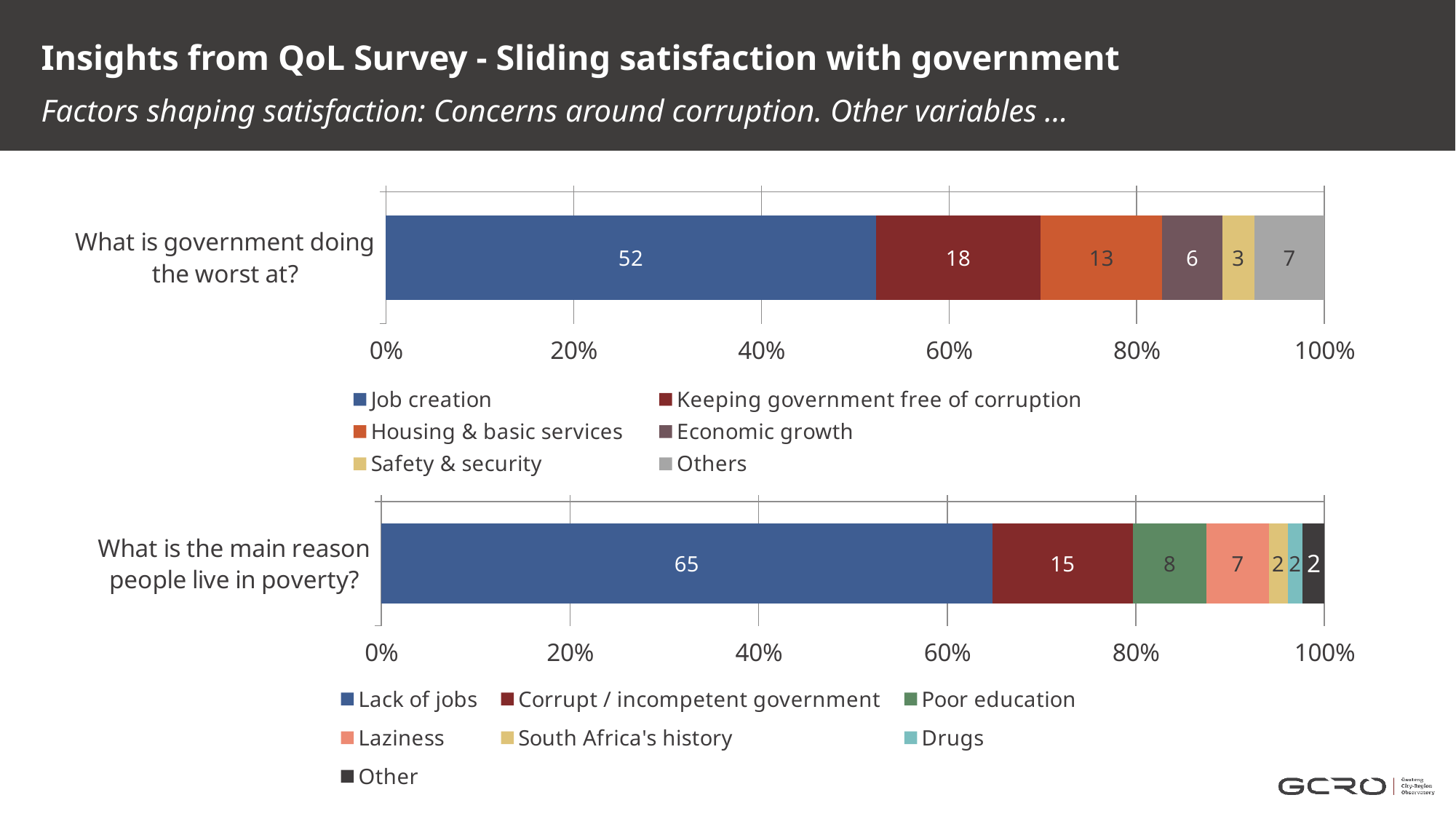
In the top chart ('What is government doing the worst at?'), how many series does the legend list? 6 In the bottom chart ('What is the main reason people live in poverty?'), which is larger: Corrupt / incompetent government or Laziness? Corrupt / incompetent government In the top chart ('What is government doing the worst at?'), which series has the smallest value? Safety & security In the bottom chart ('What is the main reason people live in poverty?'), what is the value for Poor education? 8 In the top chart ('What is government doing the worst at?'), what is the value for Keeping government free of corruption? 18 In the bottom chart ('What is the main reason people live in poverty?'), how many series does the legend list? 7 In the top chart ('What is government doing the worst at?'), which series has the largest value? Job creation In the top chart ('What is government doing the worst at?'), what is the value for Job creation? 52 In the bottom chart ('What is the main reason people live in poverty?'), what is the value for Lack of jobs? 65 In the bottom chart ('What is the main reason people live in poverty?'), what is the difference between Lack of jobs and Corrupt / incompetent government? 50 What kind of chart is the top chart ('What is government doing the worst at?')? Stacked bar chart In the top chart ('What is government doing the worst at?'), what is the difference between Housing & basic services and Economic growth? 7